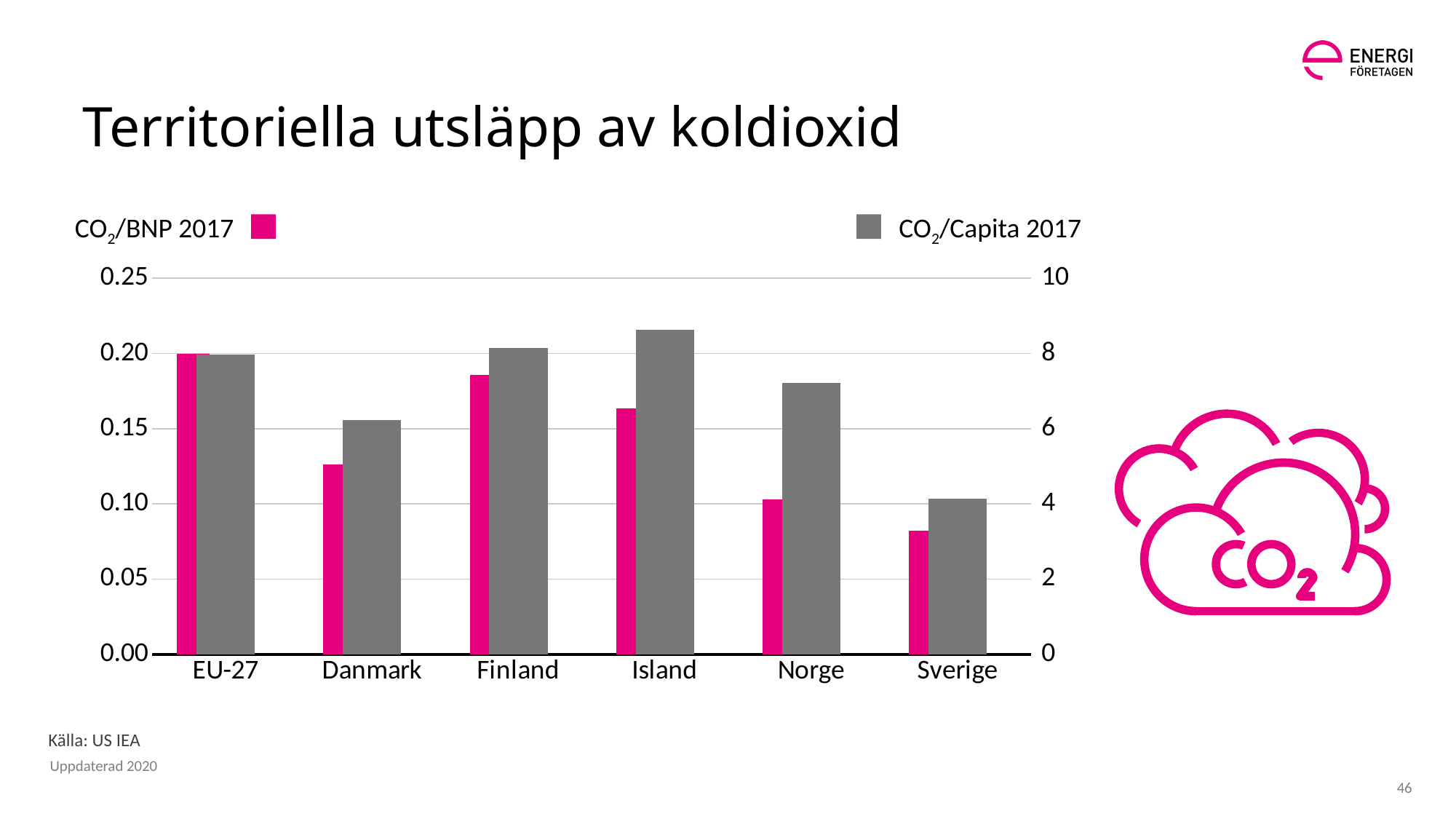
Is the CO2/BNP 2017 value for Danmark greater or less than 0.15? less Which category has the highest CO2/BNP 2017 value? EU-27 What kind of chart is shown on the slide? bar chart Which has the larger CO2/BNP 2017 value, Danmark or Norge? Danmark Is the CO2/Capita 2017 value for Norge greater or less than 6? greater Which category has the highest CO2/Capita 2017 value? Island Is the CO2/Capita 2017 value for Sverige greater or less than 6? less How many countries/regions are shown on the x axis of the chart? 6 Which category has the lowest CO2/BNP 2017 value? Sverige Which category has the lowest CO2/Capita 2017 value? Sverige Which colour represents the CO2/Capita 2017 series in the chart? grey How many series does the chart's legend list? 2